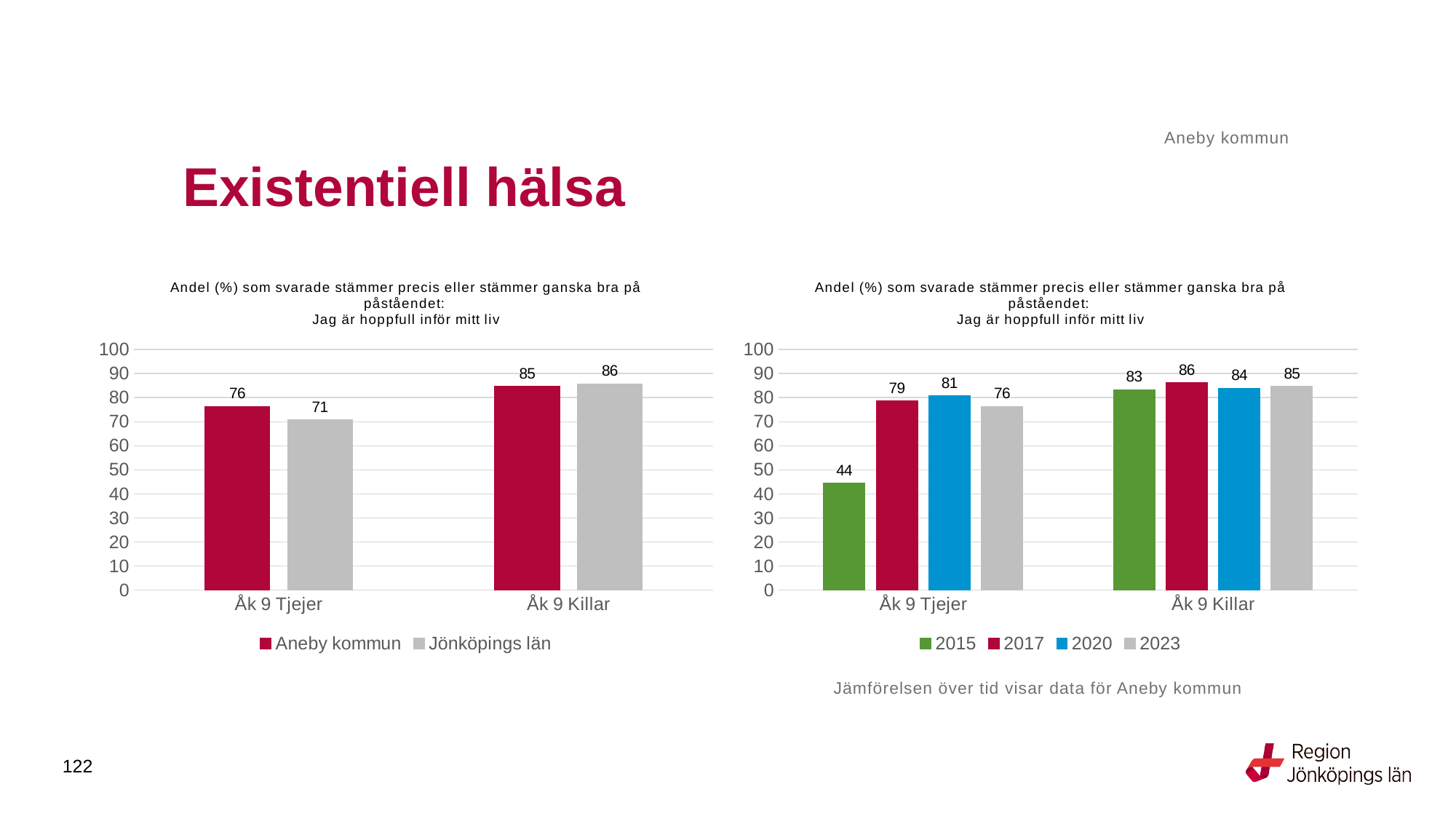
What kind of chart is the right chart? Bar chart In the left chart, what is the difference between Aneby kommun and Jönköpings län for Åk 9 Tjejer? 5 In the left chart, what is the value for Jönköpings län for Åk 9 Killar? 86 In the right chart, what is the value for 2015 for Åk 9 Tjejer? 44 In the right chart, how many series does the legend list? 4 In the right chart, which year has the highest value for Åk 9 Killar? 2017 In the right chart, which year has the lowest value for Åk 9 Tjejer? 2015 In the right chart, what is the value for 2020 for Åk 9 Killar? 84 In the left chart, how many series does the legend list? 2 In the left chart, what is the value for Aneby kommun for Åk 9 Tjejer? 76 In the right chart, what is the difference between the 2023 values for Åk 9 Killar and Åk 9 Tjejer? 9 In the left chart, which is larger for Åk 9 Killar: Aneby kommun or Jönköpings län? Jönköpings län